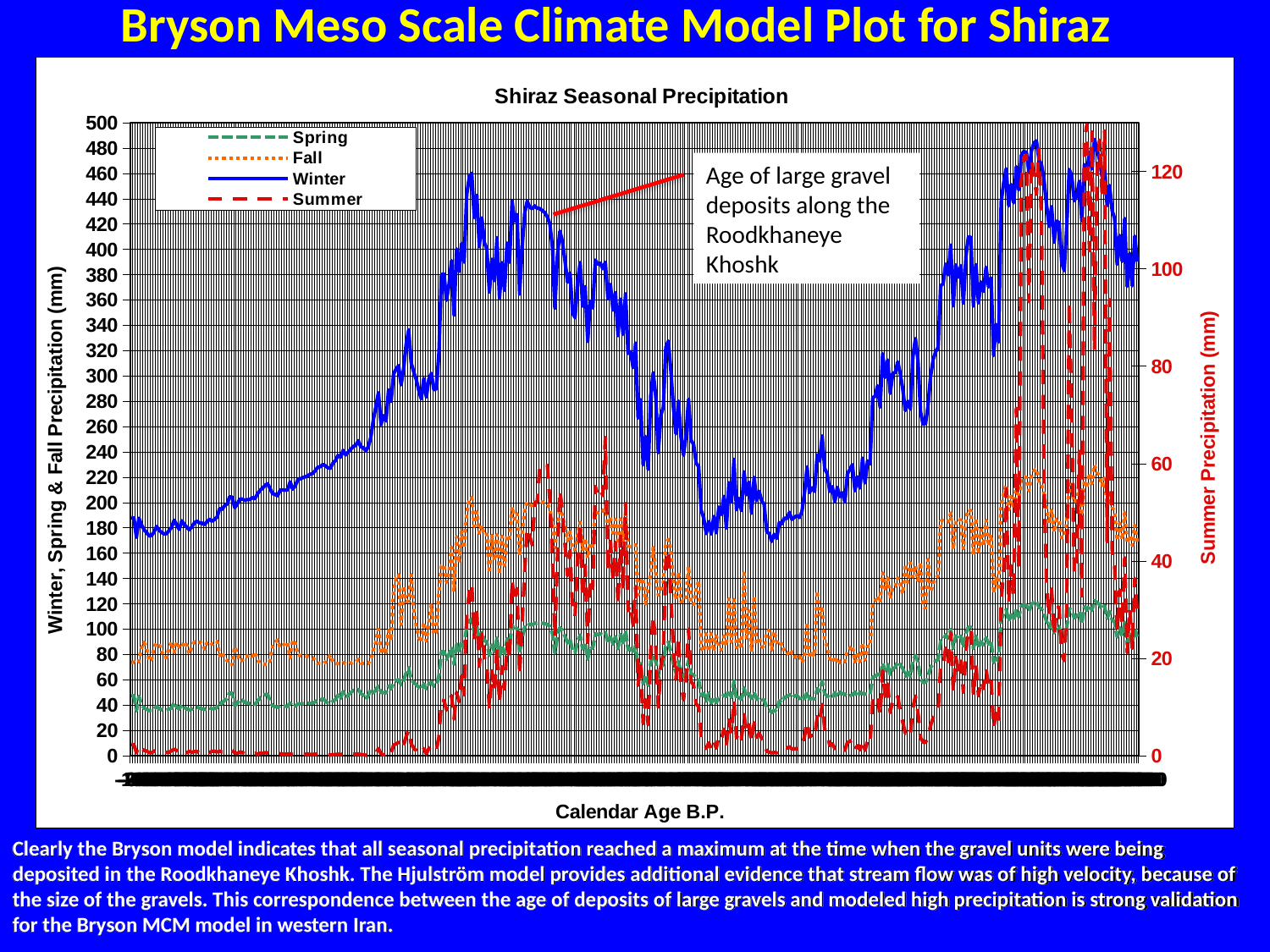
What is the title of the chart on the slide? Shiraz Seasonal Precipitation Which series is plotted against the right-hand axis labelled Summer Precipitation (mm)? Summer What is the maximum value shown on the left-hand y axis? 500 At the left edge of the chart, is the Winter value greater or less than 100? greater At the left edge of the chart, is the Spring value greater or less than 100? less Which series reaches the highest values on the chart? Winter Is the highest value reached by the Spring series greater or less than 140? less At the left edge of the chart, which is larger, the Winter value or the Fall value? Winter How many series does the legend of the Shiraz Seasonal Precipitation chart list? 4 What type of chart is shown on the slide? line chart What is the label of the x axis of the chart? Calendar Age B.P.